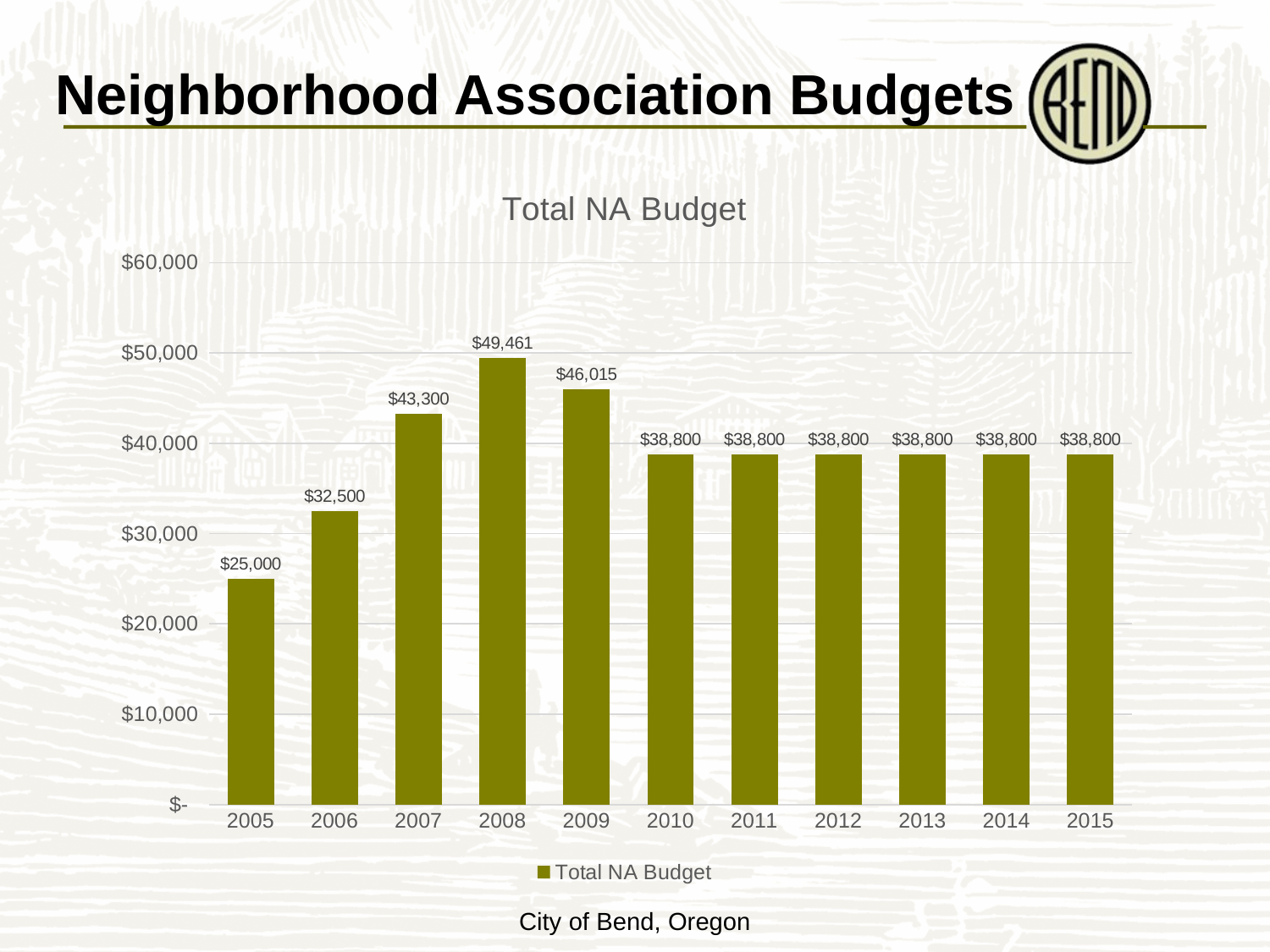
What is the Total NA Budget for 2012? $38,800 How many years are shown on the x axis of the chart? 11 Which year has the highest Total NA Budget? 2008 How many series does the legend list? 1 Which year has a larger Total NA Budget, 2007 or 2009? 2009 Does the Total NA Budget rise or fall from 2005 to 2008? Rise What is the difference between the Total NA Budget in 2007 and in 2006? $10,800 Which year has the lowest Total NA Budget? 2005 What is the difference between the Total NA Budget in 2008 and in 2009? $3,446 What kind of chart is shown on the slide? Bar chart What is the Total NA Budget for 2005? $25,000 What is the Total NA Budget for 2008? $49,461